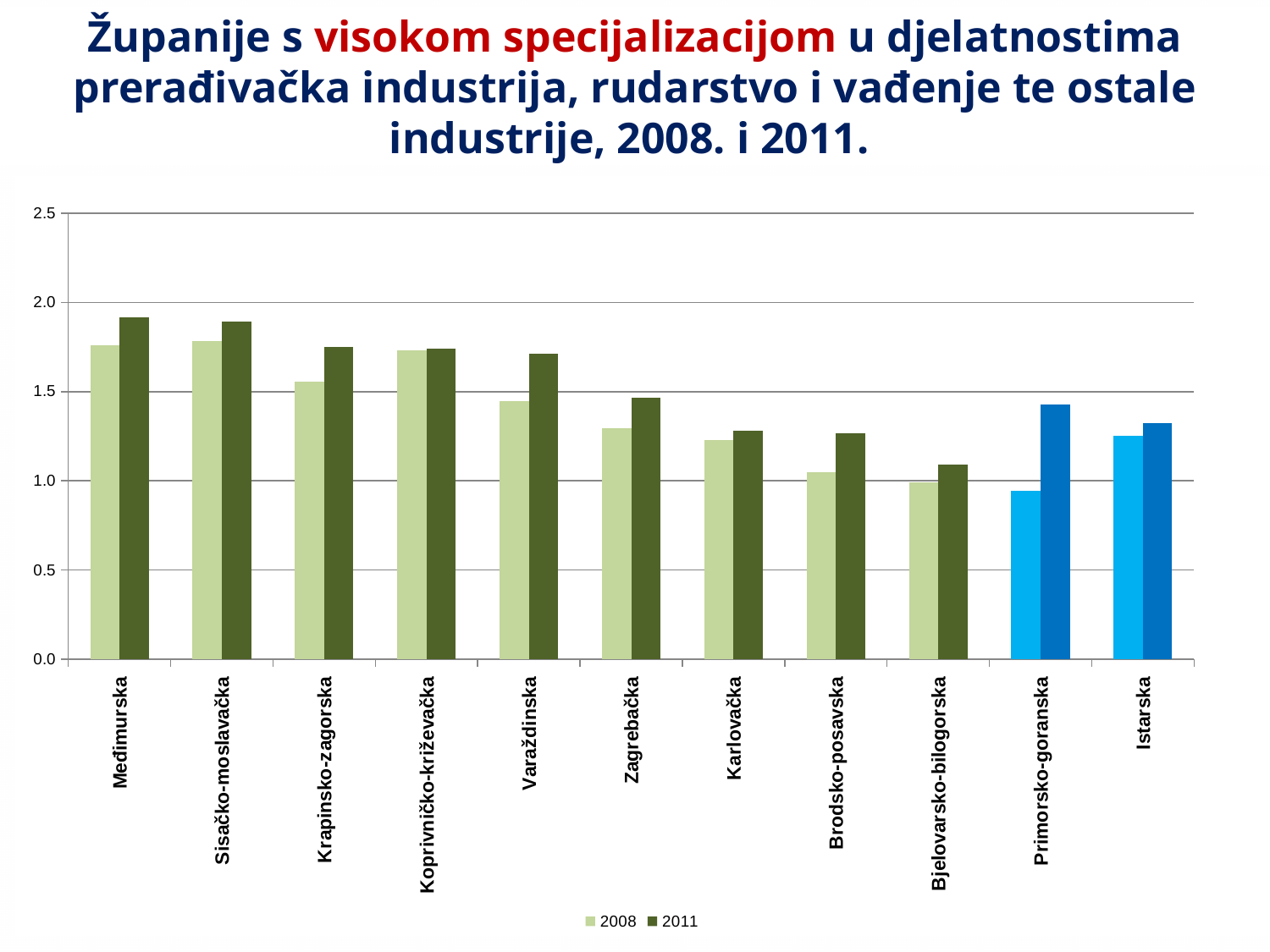
Is the 2008 value for Varaždinska greater or less than 1.5? less Is the 2011 value for Međimurska greater or less than 1.5? greater Is the 2008 value for Primorsko-goranska greater or less than 1.0? less How many series does the legend list? 2 Which two counties are shown with blue bars instead of green? Primorsko-goranska and Istarska Which is larger: the 2011 value for Međimurska or the 2011 value for Karlovačka? Međimurska For Primorsko-goranska, which year has the larger value, 2008 or 2011? 2011 What kind of chart is shown on the slide? bar chart How many counties (categories) are shown on the x axis? 11 Which years are listed in the legend? 2008 and 2011 Which county has the lowest value for 2011? Bjelovarsko-bilogorska